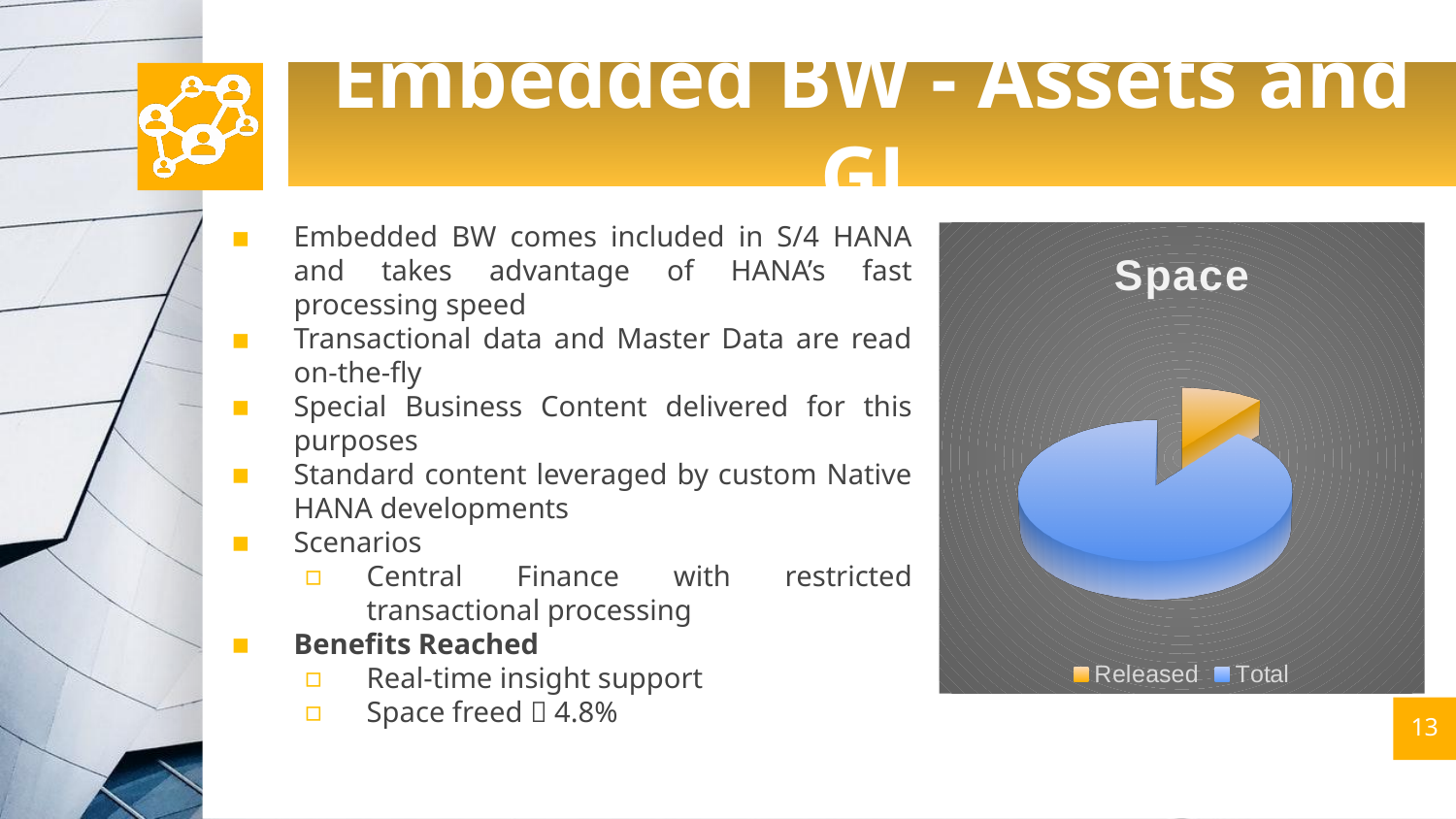
What kind of chart is shown on the slide? pie chart Which slice of the pie chart is the largest? Total How many entries does the chart's legend list? 2 What colour is the Released slice in the pie chart? orange Which slice of the pie chart is the smallest? Released How many slices does the pie chart have? 2 What is the title of the chart on the slide? Space Which is larger in the pie chart, Released or Total? Total